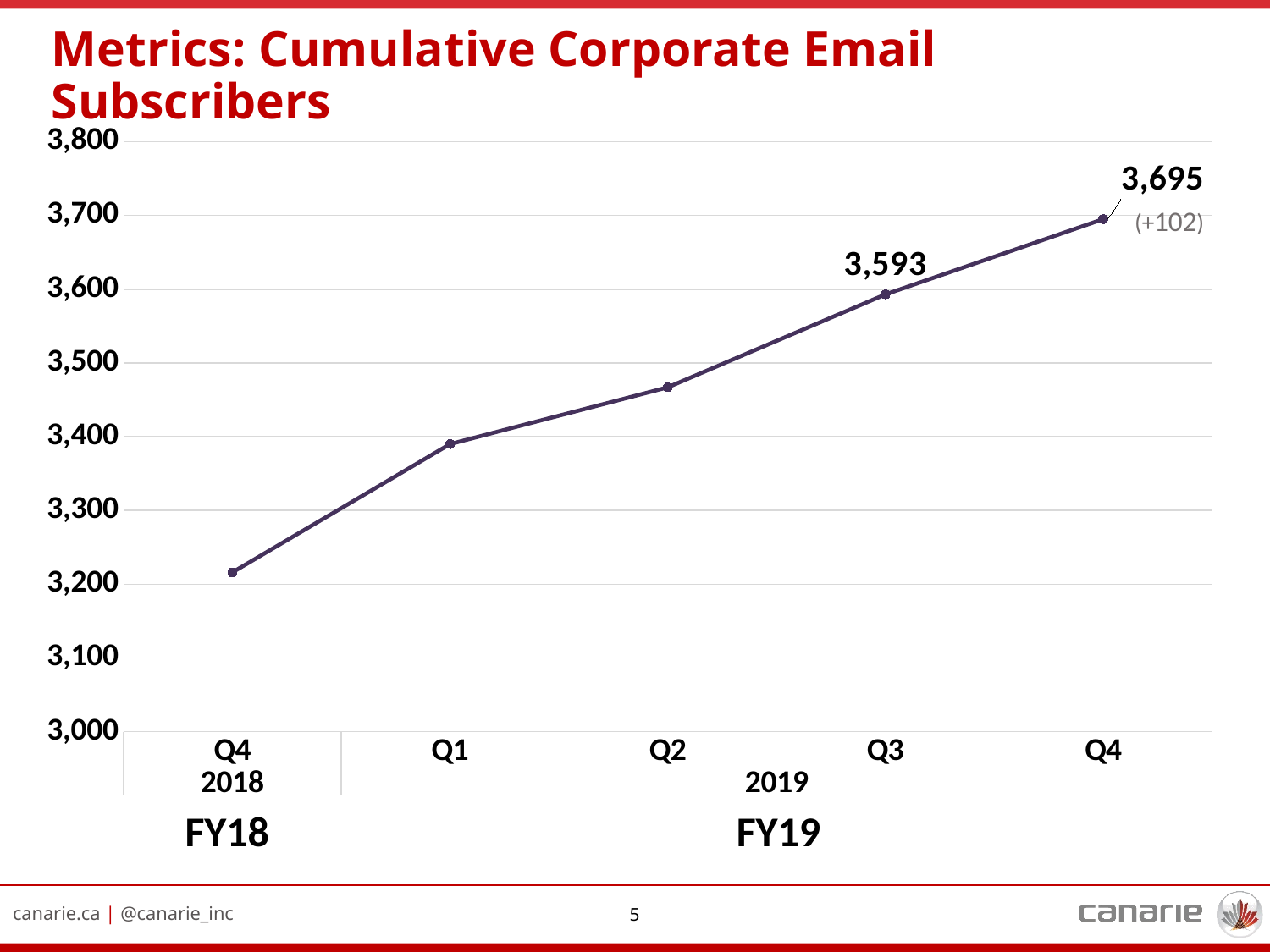
Is the value for Q4 2018 greater or less than 3,300? less What is the value for Q4 2019? 3,695 Is the value for Q2 2019 greater or less than 3,500? less What kind of chart is shown? line chart What is the difference between the Q4 2019 and Q3 2019 values? 102 How many data points are plotted on the chart? 5 Which quarter has the highest value? Q4 2019 What is the value for Q3 2019? 3,593 Which quarter has the lowest value? Q4 2018 Is the value for Q1 2019 greater or less than 3,300? greater Which is larger, the value for Q2 2019 or the value for Q1 2019? Q2 2019 Do the values rise or fall from Q4 2018 to Q4 2019? rise